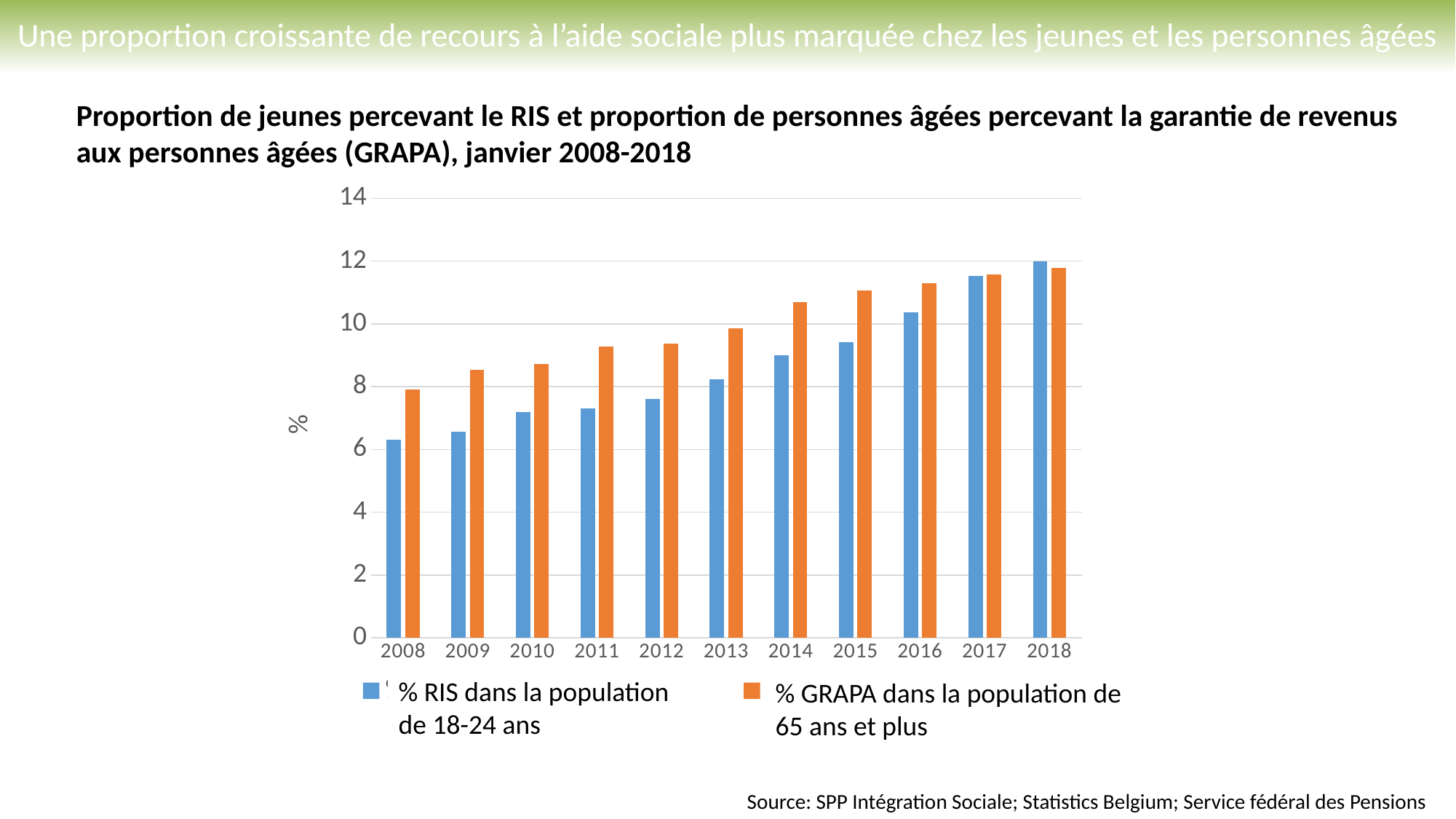
Which year has the highest value for % GRAPA dans la population de 65 ans et plus? 2018 How many years are shown on the x axis? 11 In 2008, which is larger: % RIS dans la population de 18-24 ans or % GRAPA dans la population de 65 ans et plus? % GRAPA dans la population de 65 ans et plus Which year has the lowest value for % RIS dans la population de 18-24 ans? 2008 Is the value for % GRAPA dans la population de 65 ans et plus in 2018 greater or less than 10? greater Do the values for % GRAPA dans la population de 65 ans et plus rise or fall from 2008 to 2018? Rise Do the values for % RIS dans la population de 18-24 ans rise or fall from 2008 to 2018? Rise Is the value for % RIS dans la population de 18-24 ans in 2014 greater or less than 10? less What kind of chart is shown on the slide? Bar chart Is the value for % RIS dans la population de 18-24 ans in 2008 greater or less than 8? less How many series does the legend list? 2